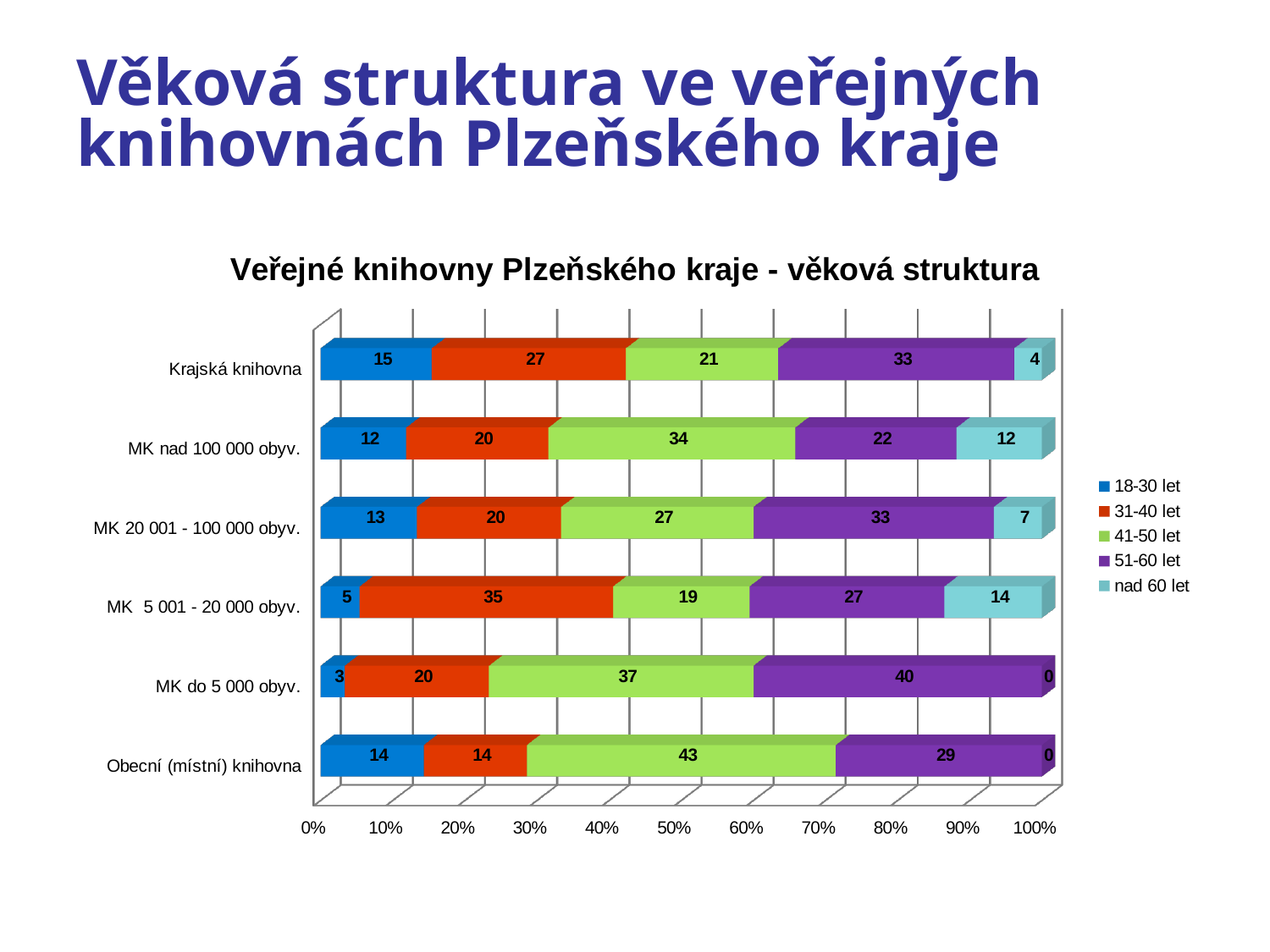
Which is larger for MK 20 001 - 100 000 obyv.: the 41-50 let value or the 51-60 let value? 51-60 let How many series does the legend list? 5 What kind of chart is shown on the slide? Stacked bar chart What is the title of the chart? Veřejné knihovny Plzeňského kraje - věková struktura Which category has the lowest value for the 18-30 let series? MK do 5 000 obyv. What is the value for the 18-30 let series for Krajská knihovna? 15 What is the value for the 31-40 let series for MK 5 001 - 20 000 obyv.? 35 How many categories are shown on the vertical axis? 6 Which category has the highest value for the 51-60 let series? MK do 5 000 obyv. What is the difference between the 51-60 let value and the 18-30 let value for Krajská knihovna? 18 What is the value for the 41-50 let series for Obecní (místní) knihovna? 43 What is the value for the nad 60 let series for MK nad 100 000 obyv.? 12